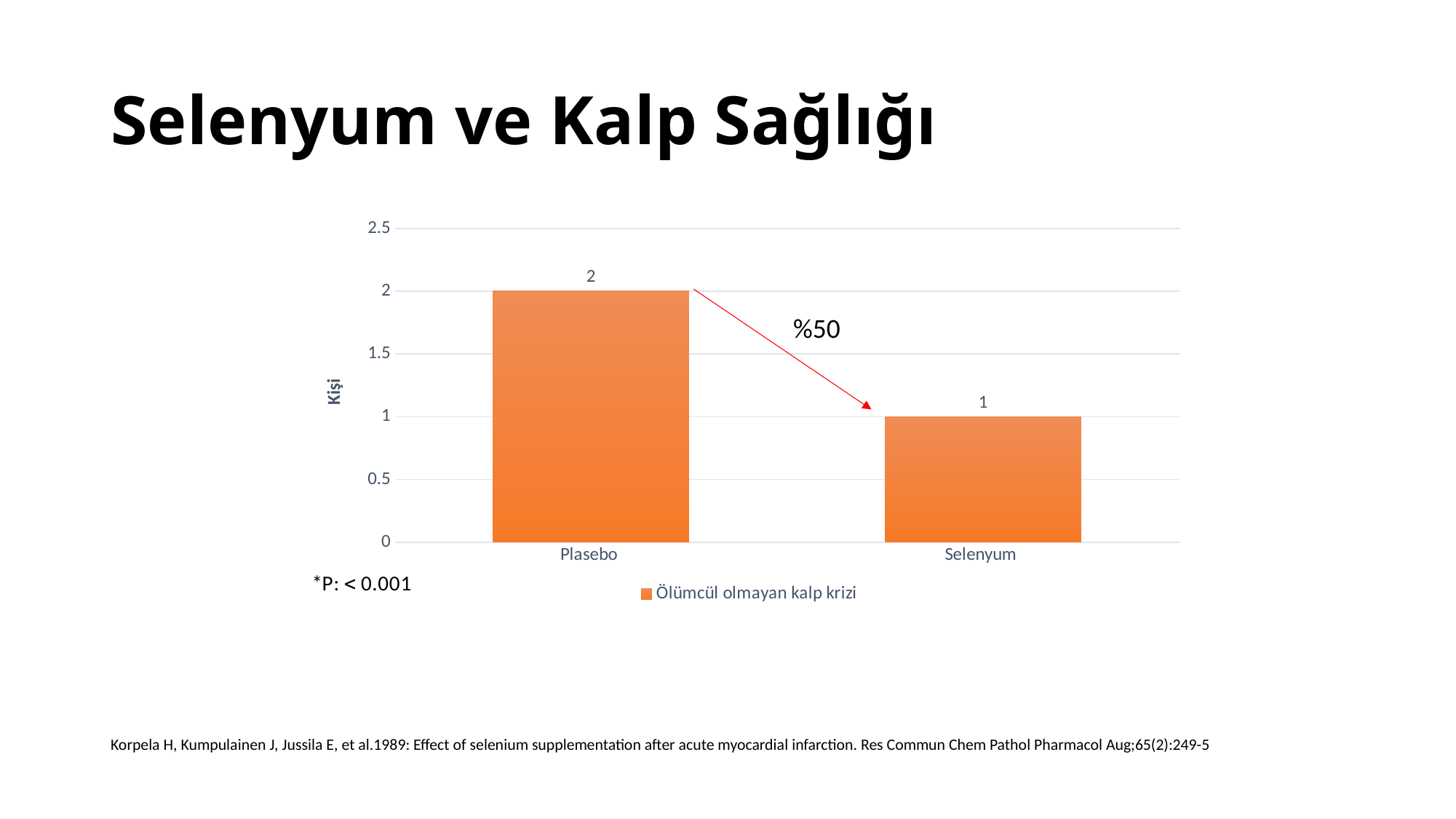
What is the difference between the values for Plasebo and Selenyum? 1 What kind of chart is shown on the slide? bar chart What is the label of the series in the legend? Ölümcül olmayan kalp krizi What is the value for Plasebo? 2 Is the value for Plasebo greater or less than 1.5? greater What is the value for Selenyum? 1 How many series does the legend list? 1 How many categories are shown on the x axis? 2 Which category has the highest value? Plasebo Which category has the lowest value? Selenyum Which is larger, the value for Plasebo or the value for Selenyum? Plasebo Do the values rise or fall from Plasebo to Selenyum? fall